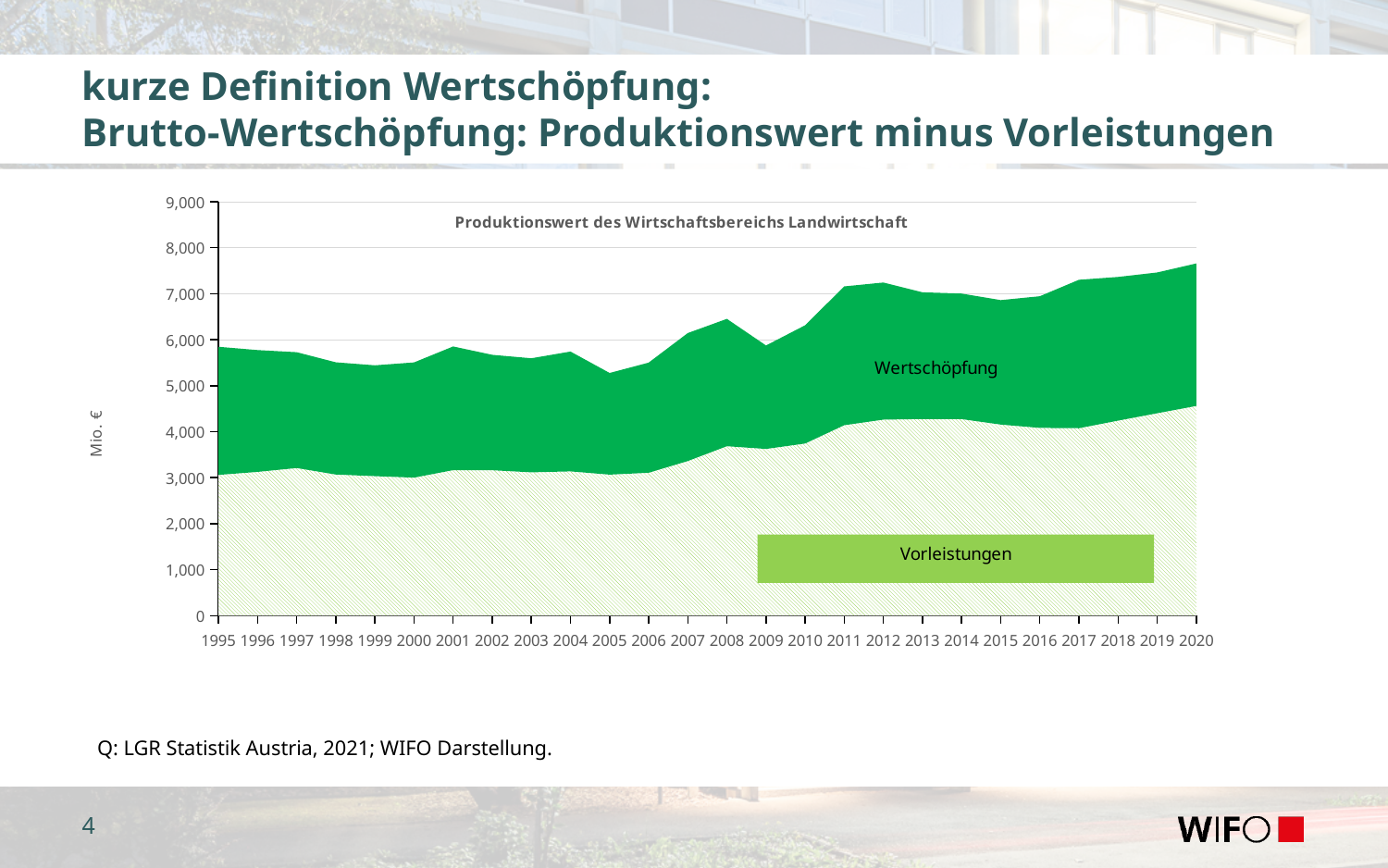
Is the total production value (top of the stacked area) in 2020 greater or less than 7,000? greater Is the value for Vorleistungen in 1995 greater or less than 4,000? less Which year has the highest total production value in the chart? 2020 What unit is shown on the y-axis label of the chart? Mio. € Is the total production value (top of the stacked area) in 1995 greater or less than 6,000? less What kind of chart is shown on the slide? Stacked area chart How many years are shown on the x axis of the chart? 26 What is the title of the chart? Produktionswert des Wirtschaftsbereichs Landwirtschaft How many series are plotted in the chart? 2 Does the total production value generally rise or fall from 1995 to 2020? rise